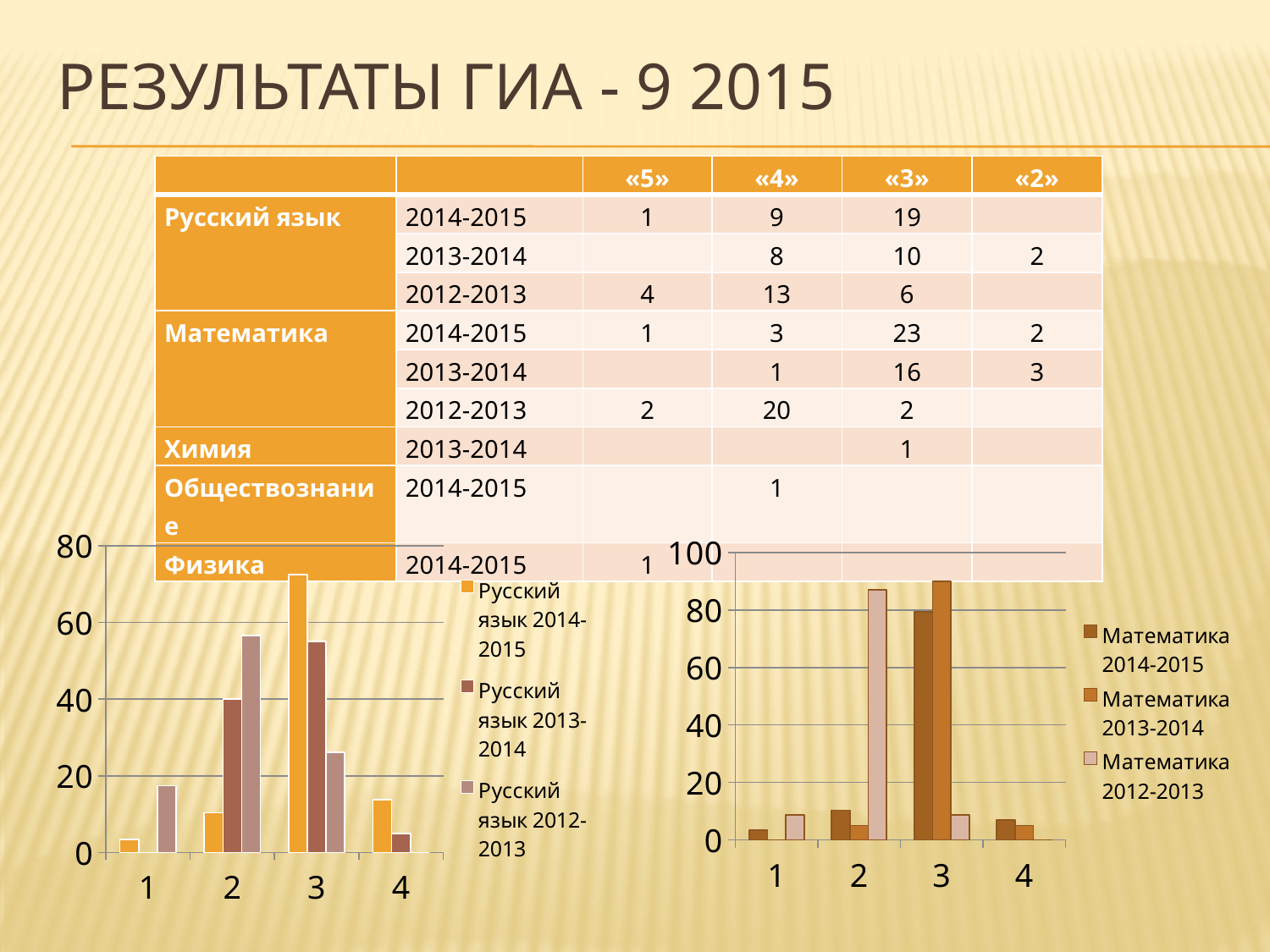
In the right chart, for category 3, which series has the larger value: Математика 2014-2015 or Математика 2013-2014? Математика 2013-2014 In the right chart, which category has the highest bar for the series Математика 2012-2013? 2 In the left chart, for category 2, which series has the larger value: Русский язык 2014-2015 or Русский язык 2012-2013? Русский язык 2012-2013 What kind of chart is the right chart on the slide? bar chart What kind of chart is the left chart on the slide? bar chart How many categories are shown on the x axis of the right chart? 4 How many series does the legend of the left chart list? 3 In the left chart, which category has the highest bar for the series Русский язык 2014-2015? 3 What is the name of the first series listed in the legend of the right chart? Математика 2014-2015 In the right chart, is the value for category 2 in the series Математика 2012-2013 greater or less than 80? greater In the left chart, is the value for category 3 in the series Русский язык 2014-2015 greater or less than 60? greater How many series does the legend of the right chart list? 3